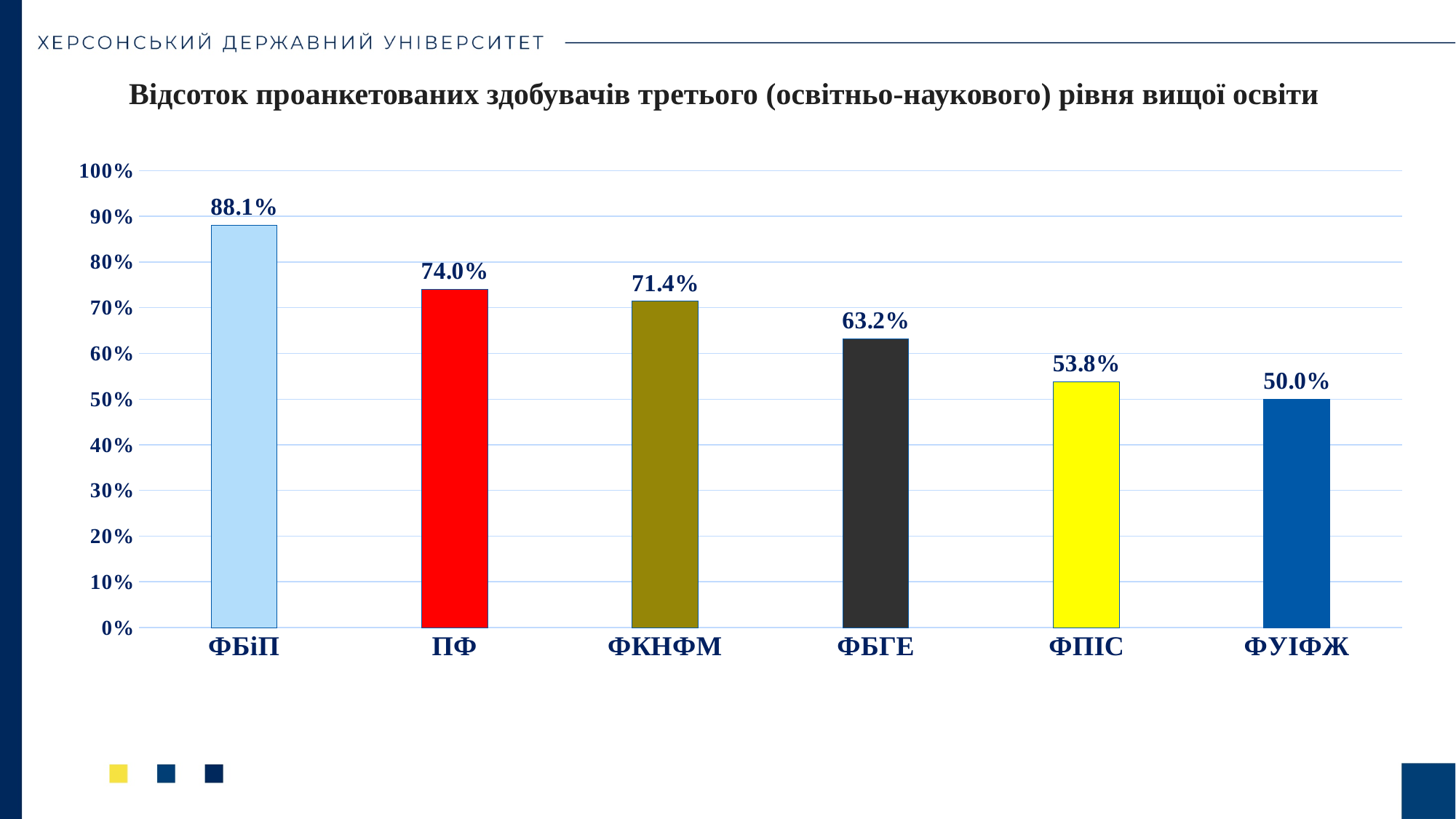
What colour is the bar for ПФ? red Do the values rise or fall from left to right along the x axis? fall Which is larger, the value for ФКНФМ or the value for ФПІС? ФКНФМ What is the value for ФБіП? 88.1% What kind of chart is shown on the slide? bar chart How many categories are shown on the x axis? 6 What is the value for ФПІС? 53.8% What is the value for ФКНФМ? 71.4% Is the value for ФБГЕ greater or less than 60%? greater Which category has the highest value? ФБіП What is the difference between the values for ПФ and ФБГЕ? 10.8% Which category has the lowest value? ФУІФЖ